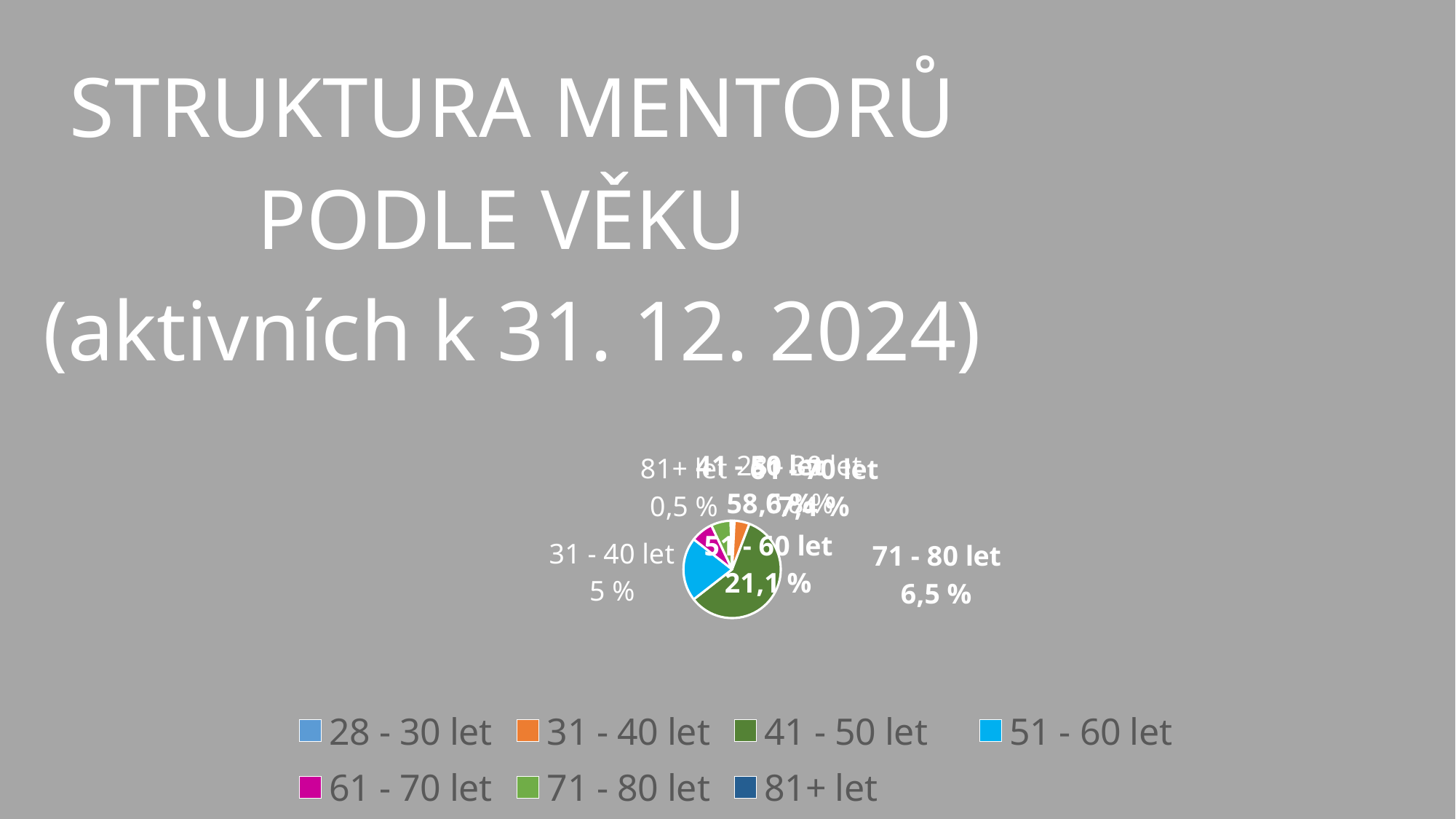
How many age categories does the legend list? 7 What date is given in the slide title for the active mentors? 31. 12. 2024 What share of mentors is in the 51 - 60 let category? 21,1 % What is the difference between the shares for 71 - 80 let and 31 - 40 let? 1,5 % What share of mentors is in the 71 - 80 let category? 6,5 % What kind of chart is shown on the slide? pie chart What share of mentors is in the 31 - 40 let category? 5 % Which is larger, the share for 31 - 40 let or for 81+ let? 31 - 40 let Which age category has the largest slice of the pie? 41 - 50 let Which is larger, the share for 51 - 60 let or for 71 - 80 let? 51 - 60 let What is the difference between the shares for 51 - 60 let and 71 - 80 let? 14,6 % What share of mentors is in the 81+ let category? 0,5 %